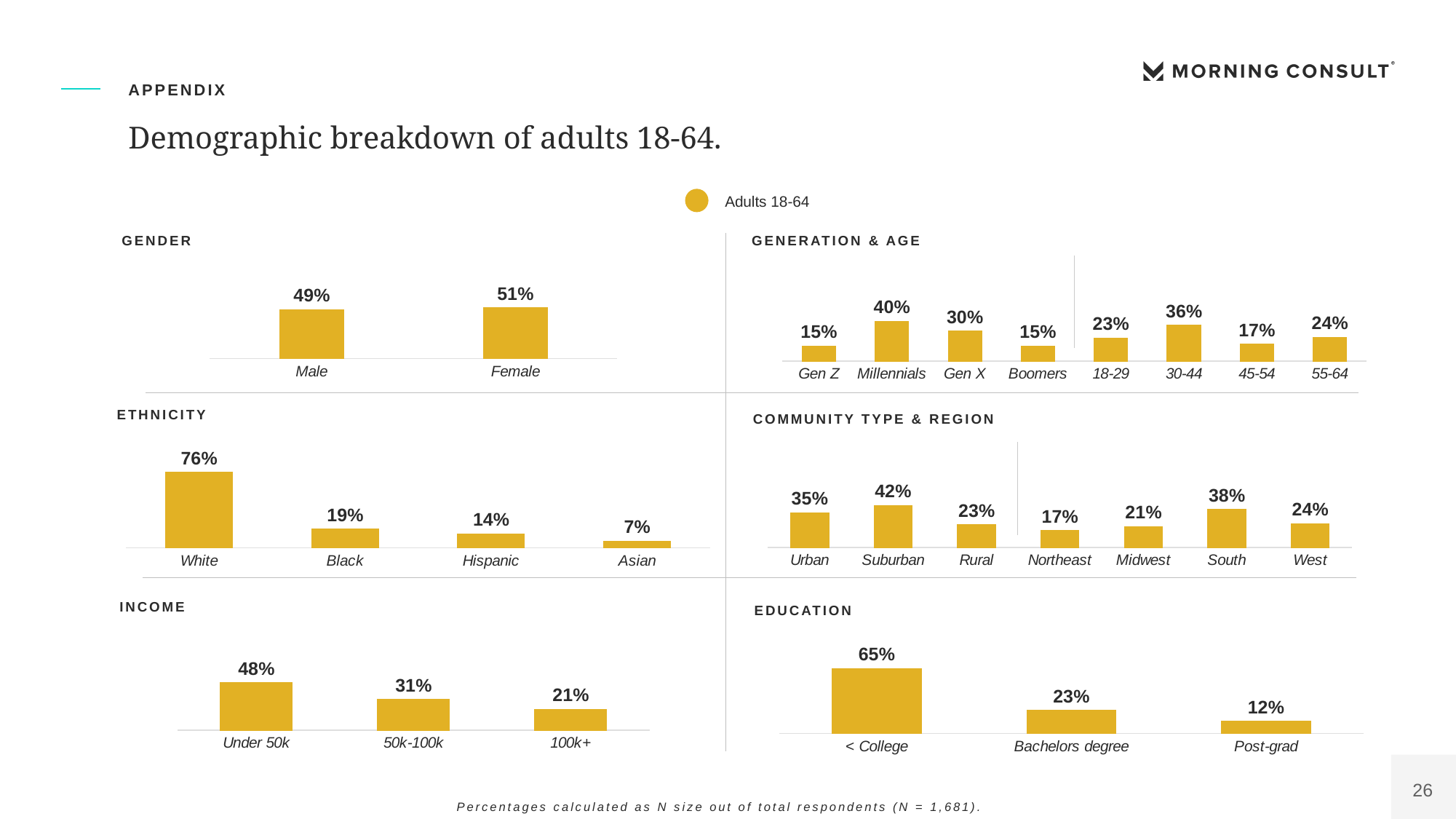
In the Income chart, do the values rise or fall from Under 50k to 100k+? Fall In the Ethnicity chart, which category has the highest value? White In the Education chart, how many categories are shown? 3 In the Generation & Age chart, what is the value for Millennials? 40% In the Community Type & Region chart, which is larger, Urban or Suburban? Suburban In the Generation & Age chart, what is the value for 30-44? 36% What kind of chart is the Income chart? Bar chart In the Ethnicity chart, which category has the lowest value? Asian In the Income chart, what is the difference between Under 50k and 100k+? 27% How many series does the legend list? 1 In the Gender chart, what is the value for Female? 51% In the Community Type & Region chart, which region has the highest value? South